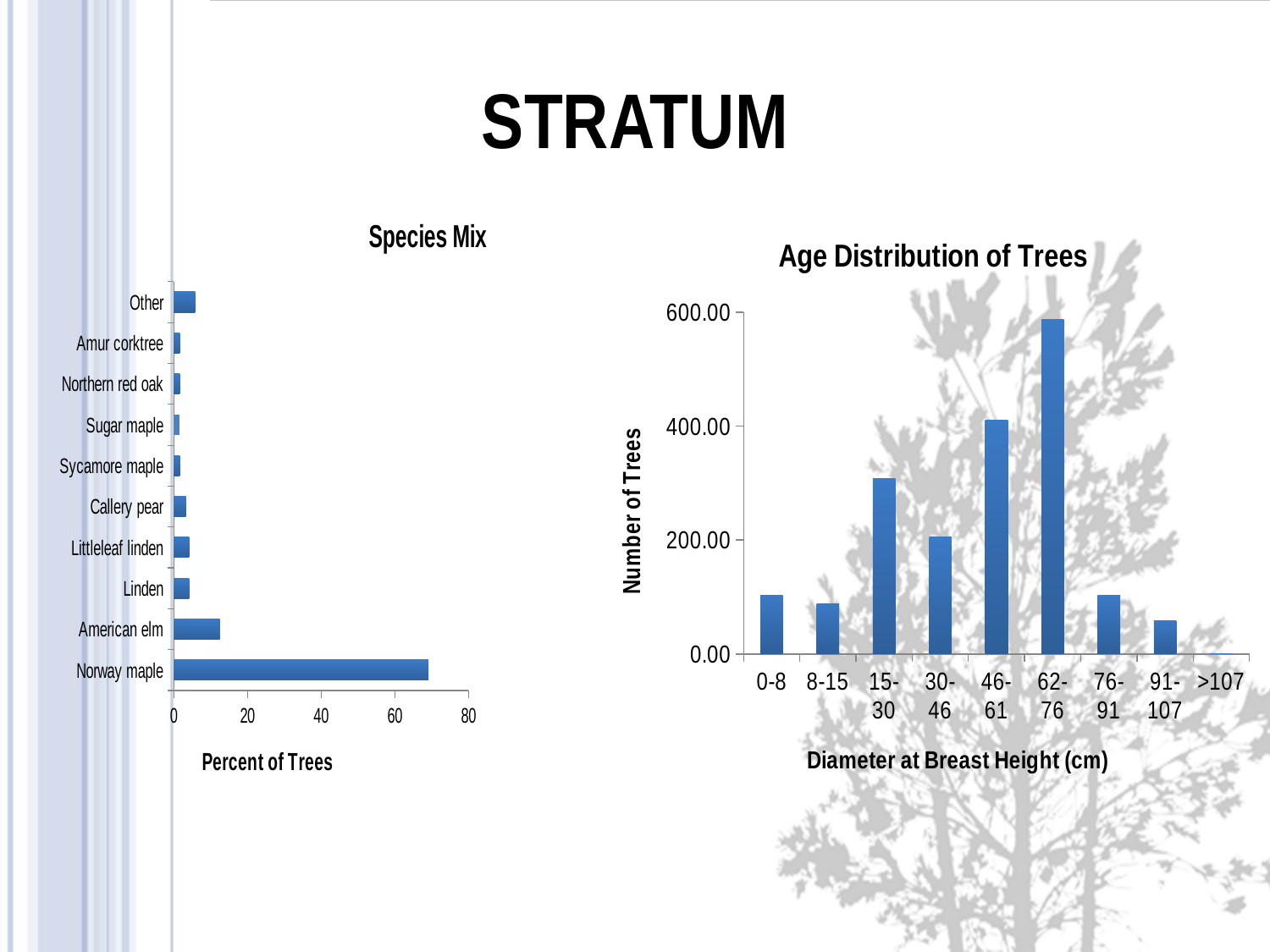
What kind of chart is the "Species Mix" chart? bar chart In the "Age Distribution of Trees" chart, is the value for 15-30 greater or less than 200.00? greater In the "Species Mix" chart, is the value for American elm greater or less than 20? less How many species categories are shown in the "Species Mix" chart? 10 In the "Species Mix" chart, which is larger, the value for American elm or the value for Other? American elm How many diameter categories are shown in the "Age Distribution of Trees" chart? 9 What is the x-axis title of the "Species Mix" chart? Percent of Trees In the "Age Distribution of Trees" chart, which diameter category has the lowest number of trees? >107 In the "Species Mix" chart, which species has the highest percent of trees? Norway maple In the "Age Distribution of Trees" chart, which is larger, the value for 46-61 or the value for 15-30? 46-61 In the "Species Mix" chart, is the value for Norway maple greater or less than 60? greater In the "Age Distribution of Trees" chart, which diameter category has the highest number of trees? 62-76